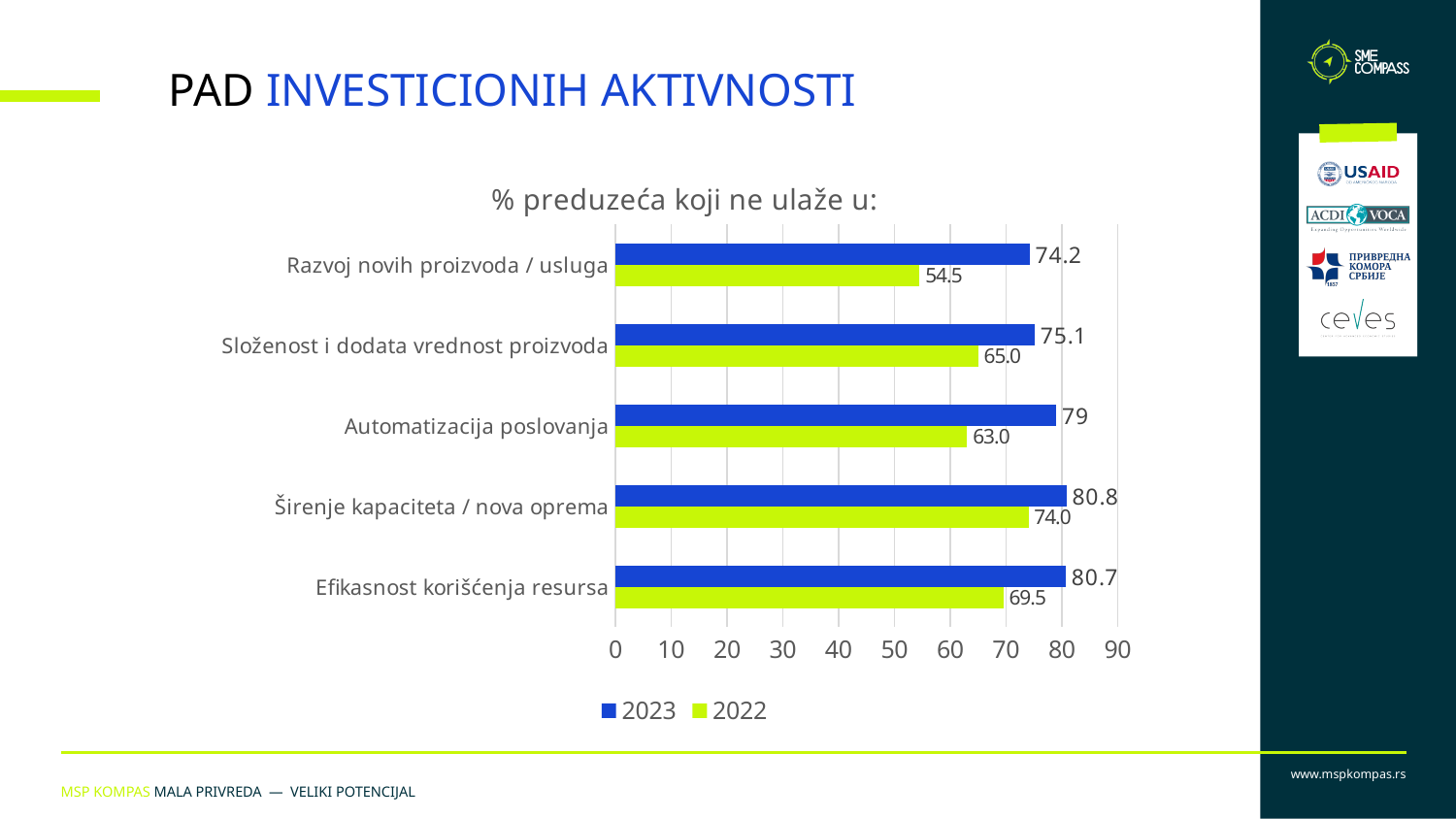
What type of chart is shown on the slide? Bar chart What is the 2023 value for Širenje kapaciteta / nova oprema? 80.8 How many series does the legend list? 2 Which category has the lowest 2022 value? Razvoj novih proizvoda / usluga What is the 2022 value for Efikasnost korišćenja resursa? 69.5 Which category has the highest 2022 value? Širenje kapaciteta / nova oprema What is the 2022 value for Automatizacija poslovanja? 63.0 What is the 2023 value for Razvoj novih proizvoda / usluga? 74.2 What is the difference between the 2023 and 2022 values for Razvoj novih proizvoda / usluga? 19.7 What is the difference between the 2023 and 2022 values for Automatizacija poslovanja? 16 Which is larger for Složenost i dodata vrednost proizvoda, the 2023 value or the 2022 value? 2023 How many categories are shown in the chart? 5